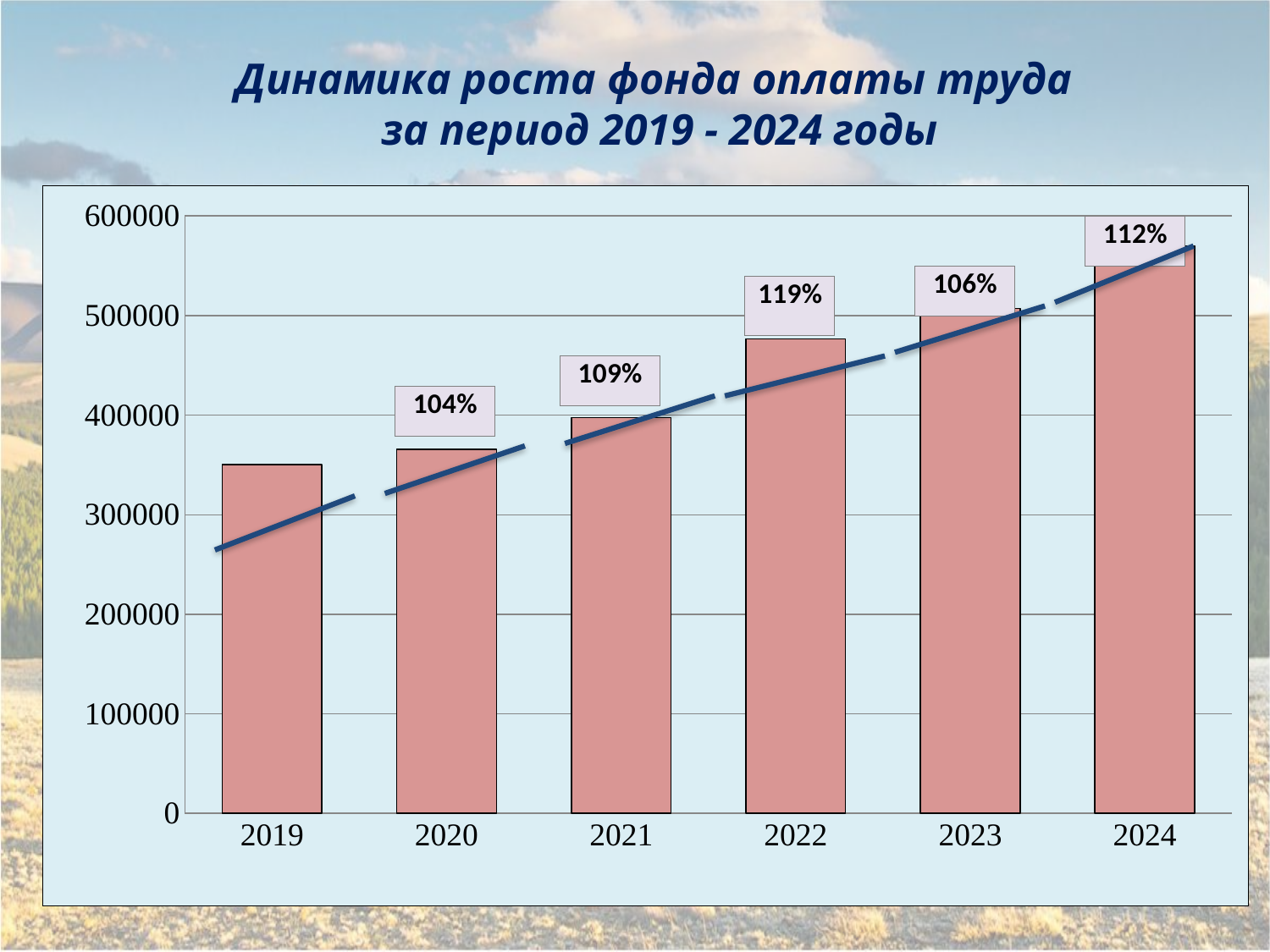
What kind of chart is shown on the slide? bar chart Which year has the highest percentage label? 2022 What percentage label is shown above the bar for 2024? 112% Which year has the tallest bar? 2024 What percentage label is shown above the bar for 2022? 119% How many years are shown on the x axis of the chart? 6 What percentage label is shown above the bar for 2020? 104% Is the value for 2024 greater or less than 500000? greater Which bar is taller, 2020 or 2022? 2022 Do the bar values rise or fall from 2019 to 2024? rise Is the value for 2019 greater or less than 400000? less Which year has the shortest bar? 2019